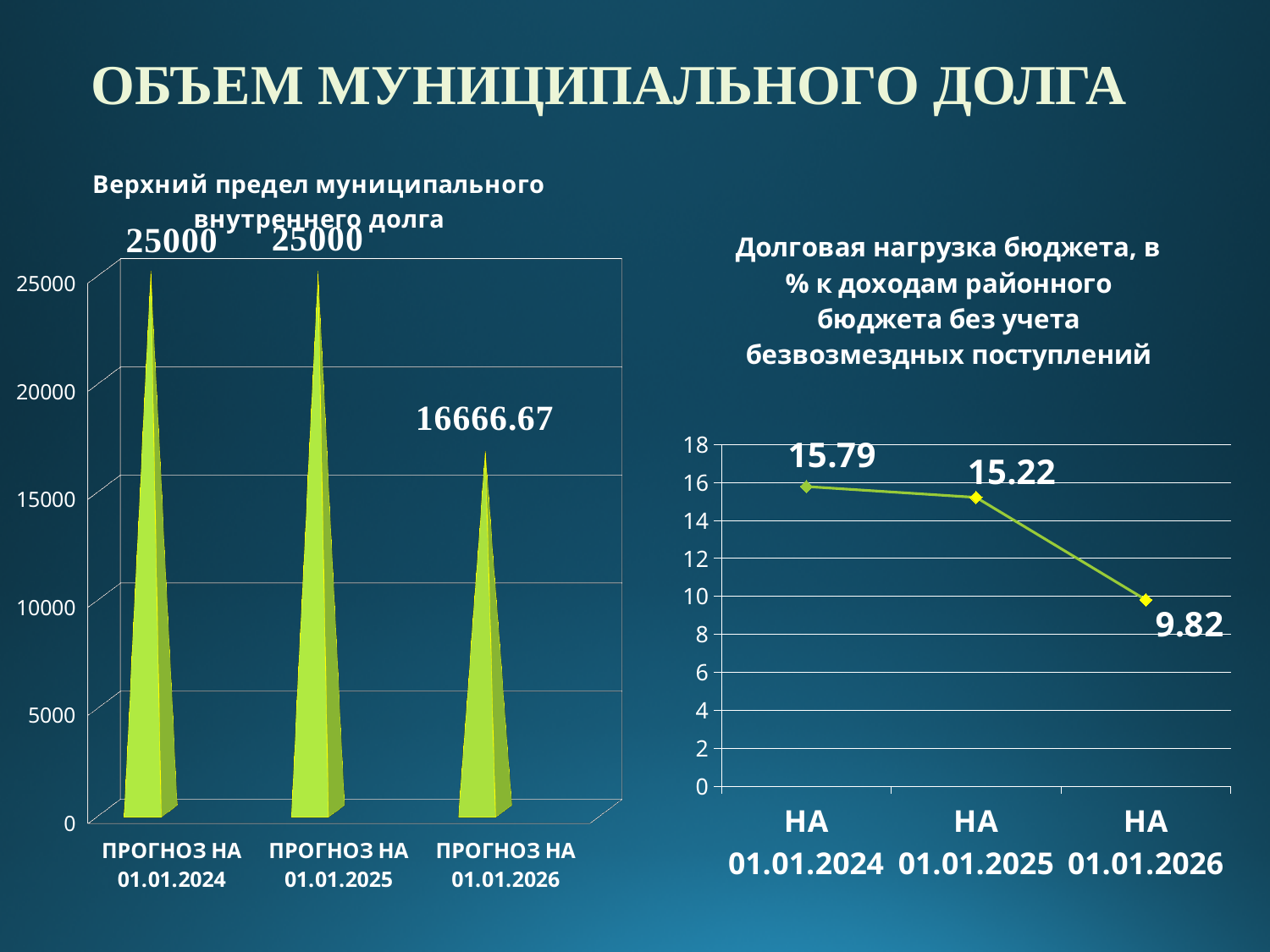
In the chart 'Долговая нагрузка бюджета', what is the difference between the values for НА 01.01.2025 and НА 01.01.2026? 5.4 In the chart 'Верхний предел муниципального внутреннего долга', which category has the lowest value? ПРОГНОЗ НА 01.01.2026 In the chart 'Долговая нагрузка бюджета', which category has the highest value? НА 01.01.2024 In the chart 'Верхний предел муниципального внутреннего долга', what is the difference between the values for ПРОГНОЗ НА 01.01.2025 and ПРОГНОЗ НА 01.01.2026? 8333.33 In the chart 'Долговая нагрузка бюджета', what is the value for НА 01.01.2024? 15.79 What kind of chart is 'Верхний предел муниципального внутреннего долга'? bar chart How many categories are shown in the chart 'Верхний предел муниципального внутреннего долга'? 3 In the chart 'Верхний предел муниципального внутреннего долга', what is the value for ПРОГНОЗ НА 01.01.2026? 16666.67 In the chart 'Долговая нагрузка бюджета', what is the value for НА 01.01.2026? 9.82 In the chart 'Долговая нагрузка бюджета', do the values rise or fall from НА 01.01.2024 to НА 01.01.2026? fall In the chart 'Верхний предел муниципального внутреннего долга', what is the value for ПРОГНОЗ НА 01.01.2024? 25000 What kind of chart is 'Долговая нагрузка бюджета'? line chart